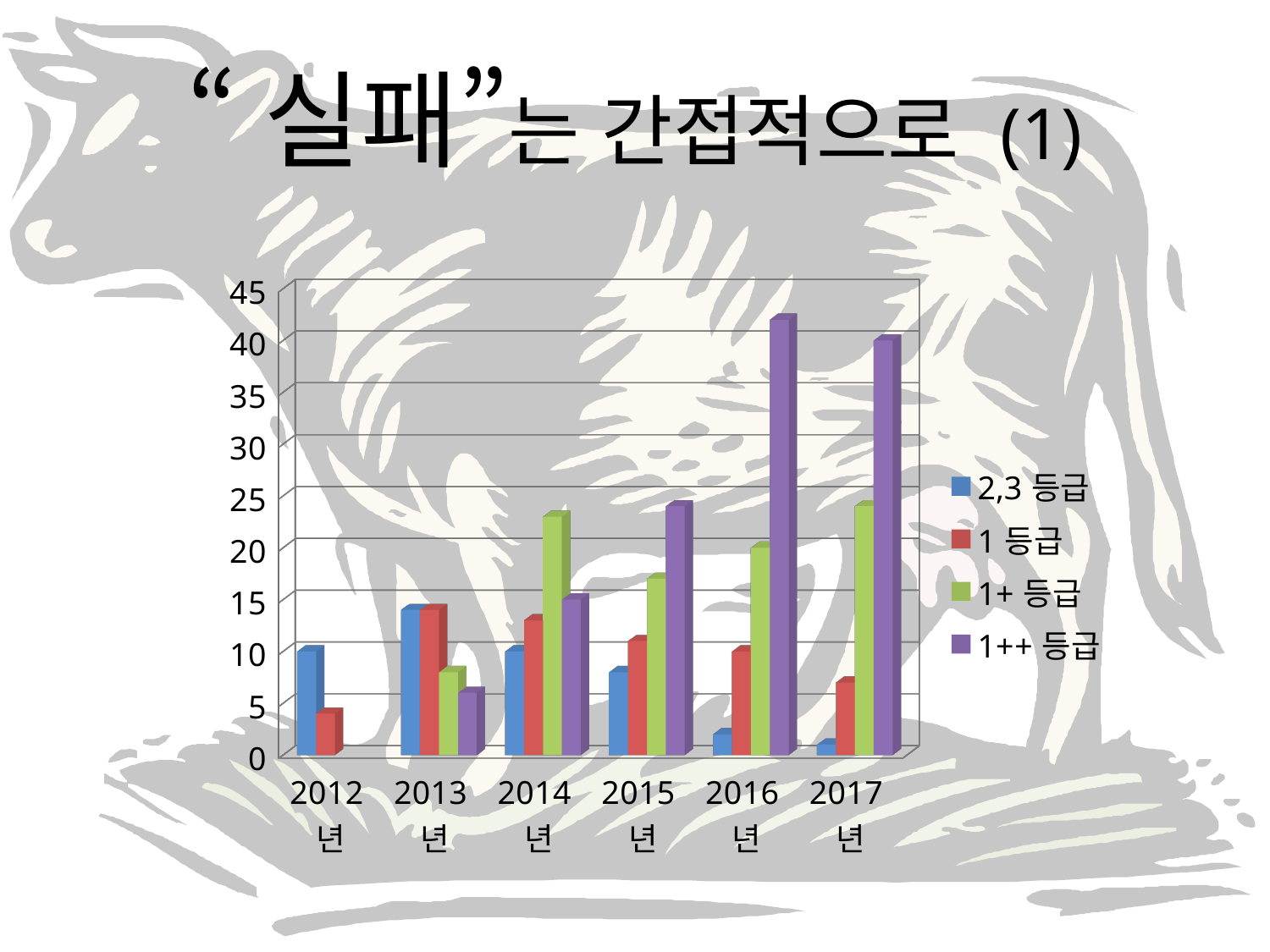
How many years are shown on the x axis? 6 In 2015년, which is larger: 1+ 등급 or 1++ 등급? 1++ 등급 Does the 1++ 등급 series rise or fall from 2013년 to 2016년? rise How many series does the legend list? 4 Is the value for 2,3 등급 in 2017년 greater or less than 5? less Is the value for 1+ 등급 in 2014년 greater or less than 20? greater Does the 2,3 등급 series rise or fall from 2013년 to 2017년? fall Which legend entry is shown in purple? 1++ 등급 What kind of chart is shown on the slide? bar chart Is the value for 1++ 등급 in 2016년 greater or less than 35? greater Which series has the tallest bar in 2016년? 1++ 등급 Which series has the shortest bar in 2017년? 2,3 등급